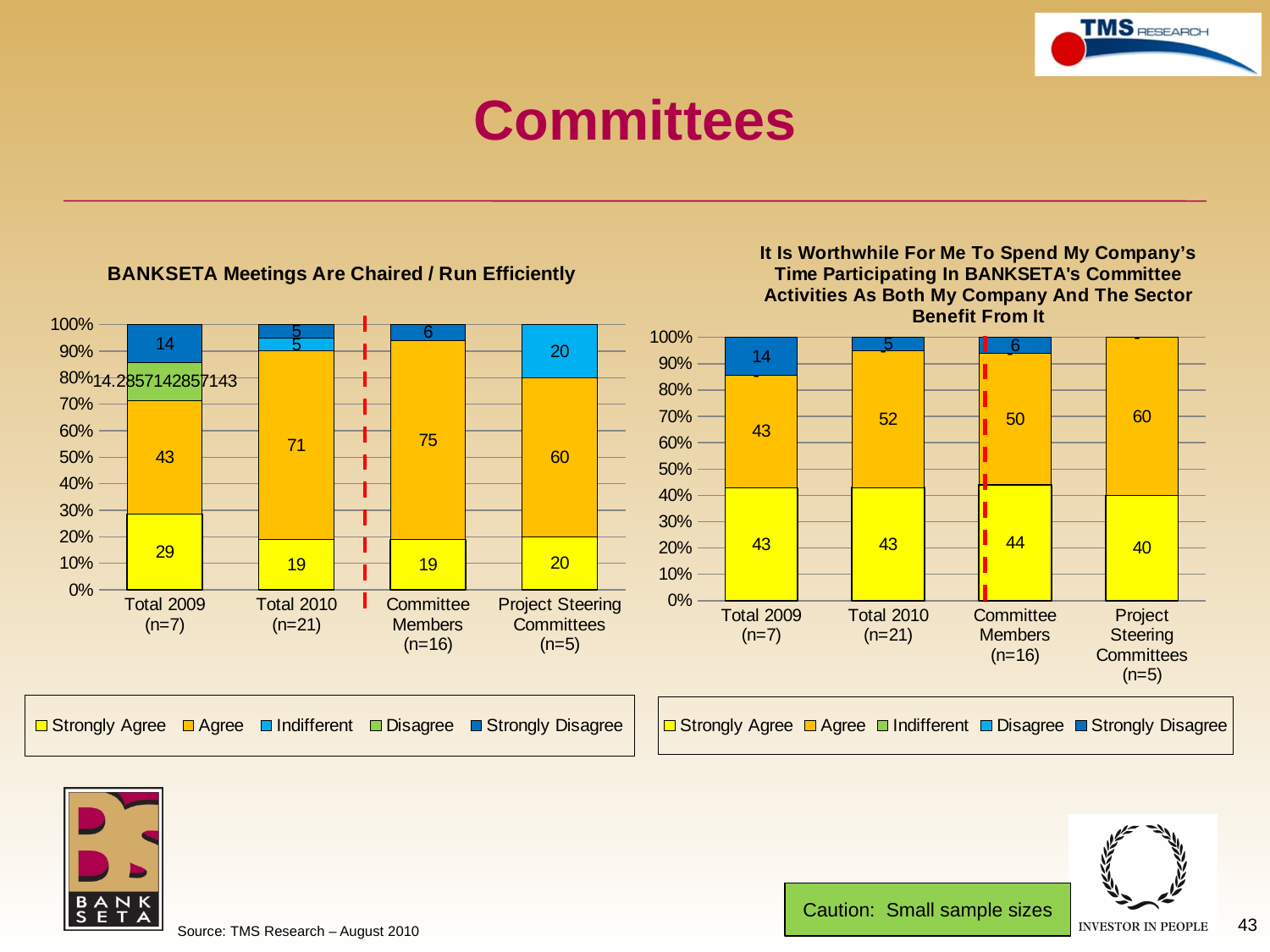
In the chart 'BANKSETA Meetings Are Chaired / Run Efficiently', which category has the highest Agree value? Committee Members (n=16) How many series does the legend of the right-hand chart list? 5 In the right-hand chart ('It Is Worthwhile For Me To Spend My Company's Time...'), what is the Agree value for Project Steering Committees (n=5)? 60 How many categories are shown on the x axis of the chart 'BANKSETA Meetings Are Chaired / Run Efficiently'? 4 In the right-hand chart ('It Is Worthwhile For Me To Spend My Company's Time...'), which category has the lowest Strongly Agree value? Project Steering Committees (n=5) What kind of chart is 'BANKSETA Meetings Are Chaired / Run Efficiently'? Stacked bar chart In the chart 'BANKSETA Meetings Are Chaired / Run Efficiently', how much higher is the Agree value for Total 2010 than for Total 2009? 28 In the right-hand chart ('It Is Worthwhile For Me To Spend My Company's Time...'), what is the Strongly Agree value for Committee Members (n=16)? 44 In the chart 'BANKSETA Meetings Are Chaired / Run Efficiently', what is the Strongly Agree value for Total 2009 (n=7)? 29 In the chart 'BANKSETA Meetings Are Chaired / Run Efficiently', what is the Indifferent value for Project Steering Committees (n=5)? 20 In the right-hand chart ('It Is Worthwhile For Me To Spend My Company's Time...'), which has the larger Agree value: Total 2010 or Committee Members? Total 2010 In the chart 'BANKSETA Meetings Are Chaired / Run Efficiently', what is the Agree value for Committee Members (n=16)? 75